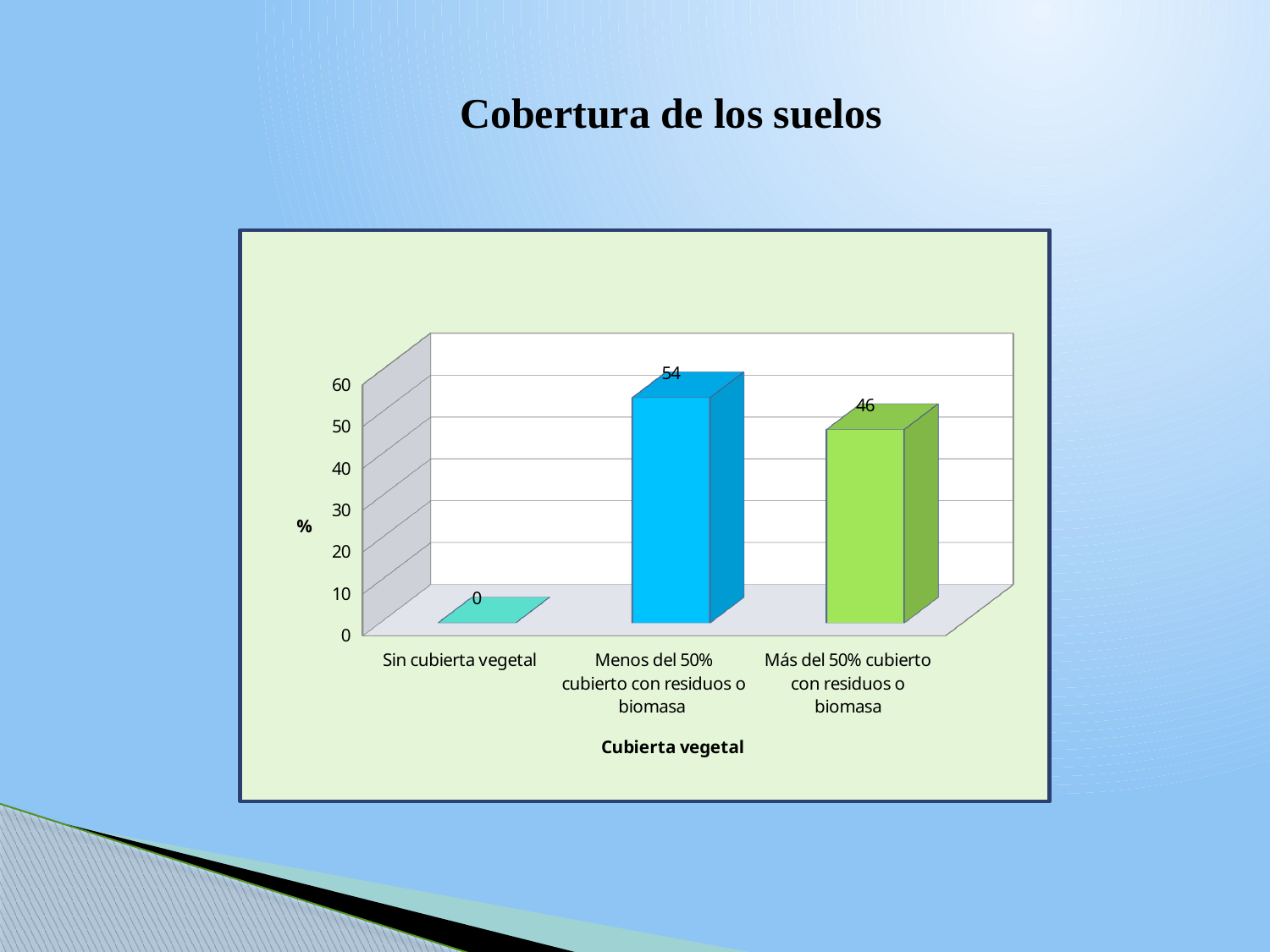
What is the difference between the values for "Menos del 50% cubierto con residuos o biomasa" and "Más del 50% cubierto con residuos o biomasa"? 8 Which category has the lowest value? Sin cubierta vegetal What is the title of the chart? Cobertura de los suelos What is the value for "Menos del 50% cubierto con residuos o biomasa"? 54 What kind of chart is shown on the slide? bar chart Which category has the highest value? Menos del 50% cubierto con residuos o biomasa What is the value for "Más del 50% cubierto con residuos o biomasa"? 46 Is the value for "Más del 50% cubierto con residuos o biomasa" greater or less than 50? less How many categories are shown on the x axis? 3 What is the label of the x axis? Cubierta vegetal What is the value for "Sin cubierta vegetal"? 0 Which is larger: the value for "Menos del 50% cubierto con residuos o biomasa" or for "Más del 50% cubierto con residuos o biomasa"? Menos del 50% cubierto con residuos o biomasa